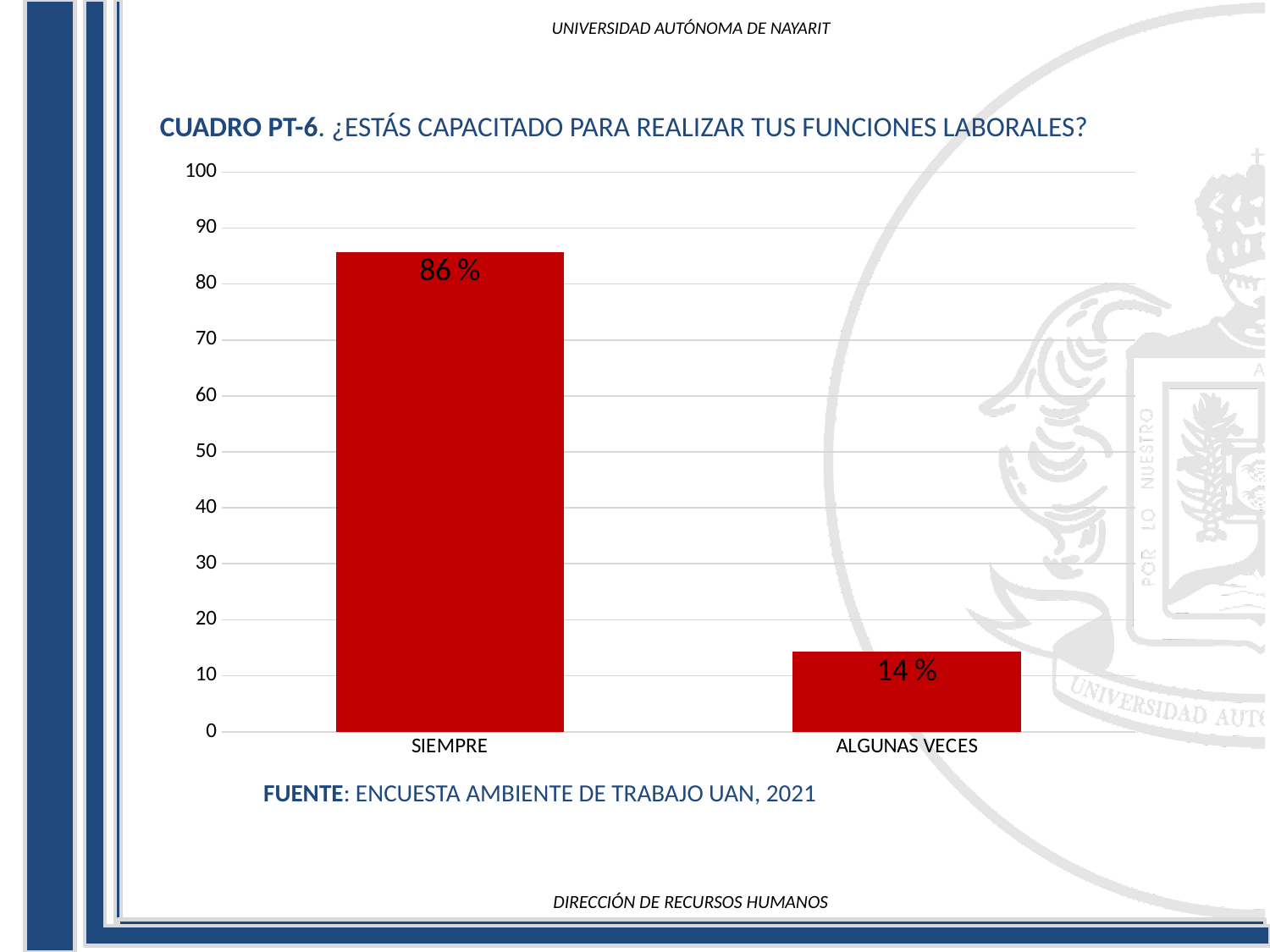
What source is cited below the chart? ENCUESTA AMBIENTE DE TRABAJO UAN, 2021 Is the value for SIEMPRE greater or less than 80? greater What is the title of the chart? CUADRO PT-6. ¿ESTÁS CAPACITADO PARA REALIZAR TUS FUNCIONES LABORALES? Is the value for ALGUNAS VECES greater or less than 20? less What is the value for ALGUNAS VECES? 14 % Which category has the highest value? SIEMPRE Which is larger, the value for SIEMPRE or the value for ALGUNAS VECES? SIEMPRE What is the value for SIEMPRE? 86 % How many categories are shown in the chart? 2 What is the difference between the values for SIEMPRE and ALGUNAS VECES? 72 % What kind of chart is shown on the slide? bar chart Which category has the lowest value? ALGUNAS VECES